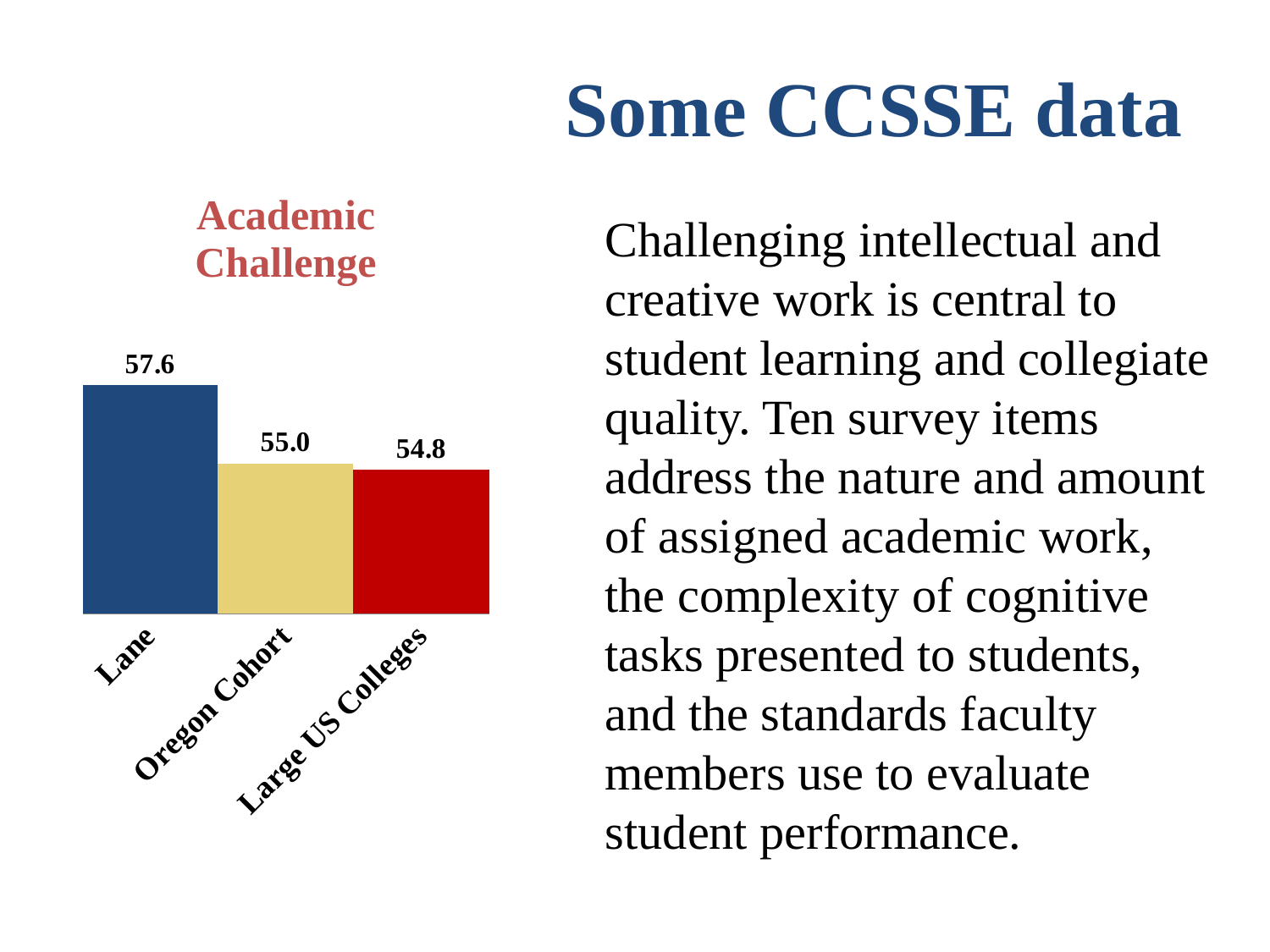
What is the value for Lane in the Academic Challenge chart? 57.6 What is the difference between the values for Lane and Oregon Cohort in the Academic Challenge chart? 2.6 What kind of chart is the Academic Challenge chart? Bar chart Do the values in the Academic Challenge chart rise or fall from left to right? Fall How many categories are shown in the Academic Challenge chart? 3 Which category has the highest value in the Academic Challenge chart? Lane Which is larger in the Academic Challenge chart, the value for Lane or the value for Oregon Cohort? Lane What is the difference between the values for Lane and Large US Colleges in the Academic Challenge chart? 2.8 What is the title of the chart on the slide? Academic Challenge What is the value for Oregon Cohort in the Academic Challenge chart? 55.0 Which category has the lowest value in the Academic Challenge chart? Large US Colleges What is the value for Large US Colleges in the Academic Challenge chart? 54.8